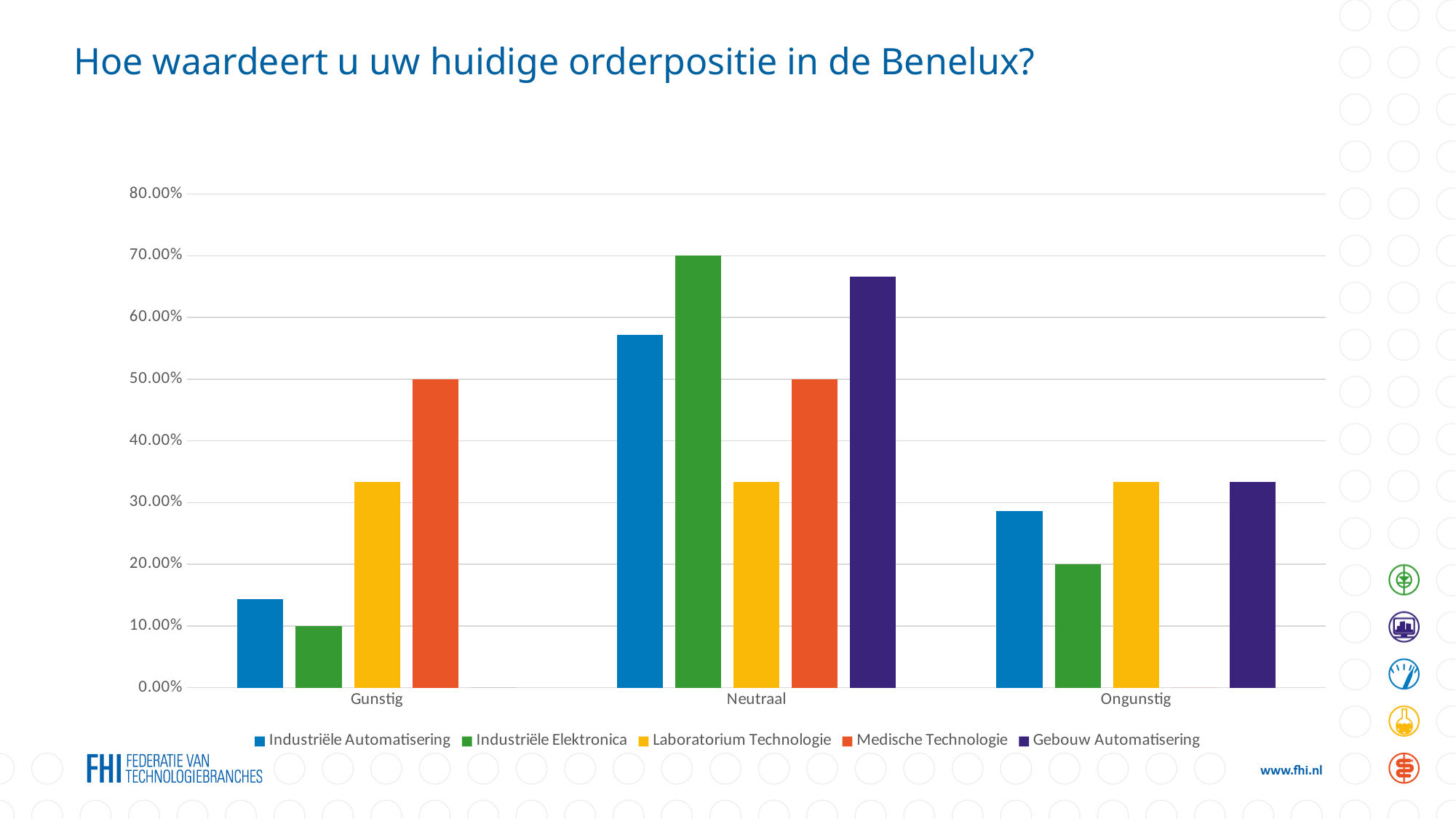
How many categories are shown on the x axis? 3 What is the value for Industriële Elektronica in the Ongunstig category? 20.00% What kind of chart is shown on the slide? bar chart What is the title of the chart? Hoe waardeert u uw huidige orderpositie in de Benelux? Which is larger in the Ongunstig category: Industriële Automatisering or Industriële Elektronica? Industriële Automatisering Which series has the highest value in the Neutraal category? Industriële Elektronica How many series does the legend list? 5 What is the value for Industriële Elektronica in the Neutraal category? 70.00% Is the value for Gebouw Automatisering in the Neutraal category greater or less than 60.00%? greater What is the value for Industriële Elektronica in the Gunstig category? 10.00% What is the value for Medische Technologie in the Gunstig category? 50.00% Which series has the lowest value in the Gunstig category? Gebouw Automatisering